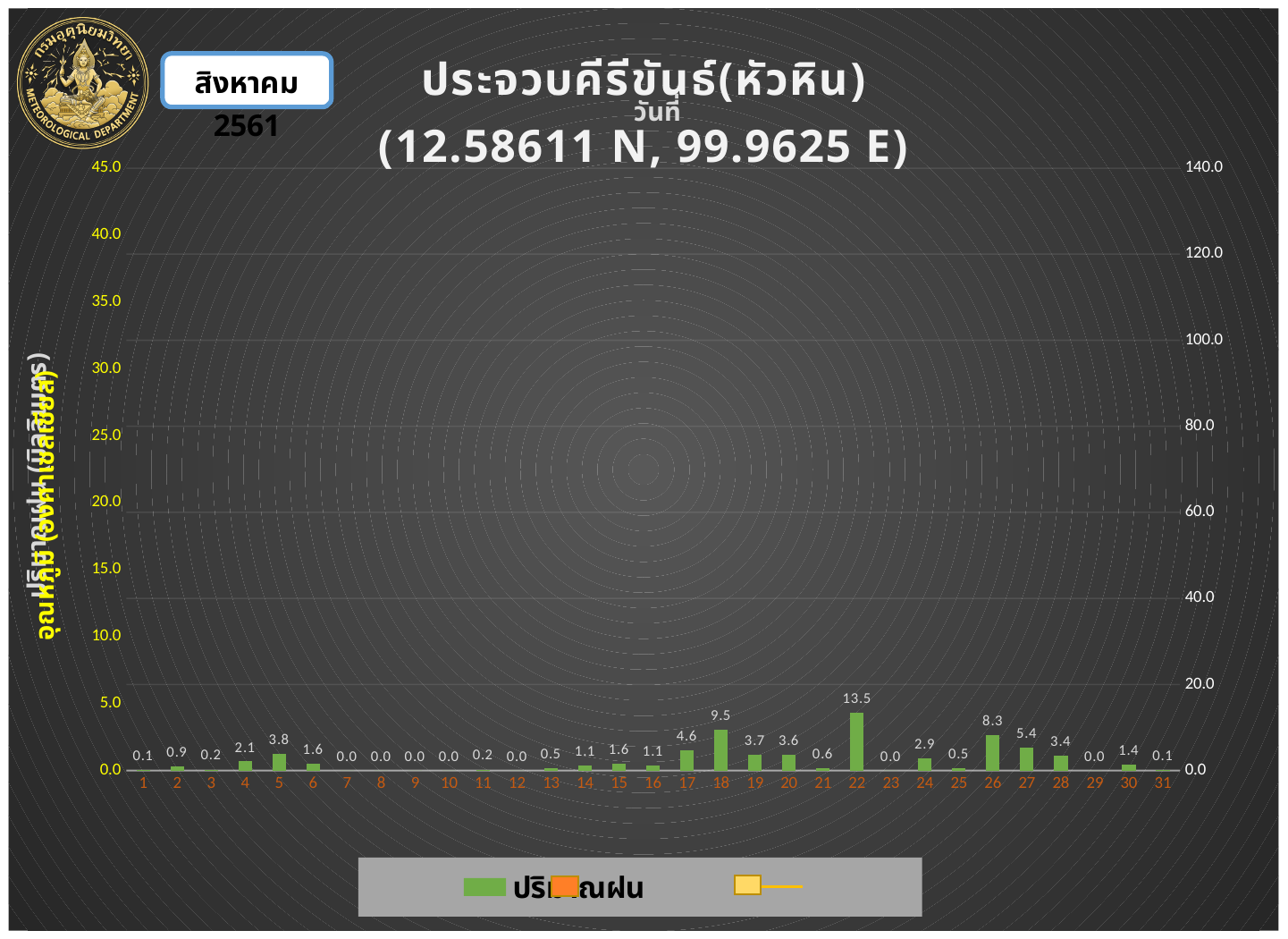
What is the value for day 18? 9.5 What is the value for day 5? 3.8 What kind of chart is this? bar chart What coordinates are given in the chart title? 12.58611 N, 99.9625 E What is the value for day 26? 8.3 What is the difference between the values for day 26 and day 27? 2.9 What is the value for day 22? 13.5 What is the difference between the values for day 22 and day 18? 4.0 Is the value for day 22 greater or less than 10.0? greater Which day has the highest value? 22 Which is larger, the value for day 17 or the value for day 19? day 17 How many days are shown on the x axis? 31